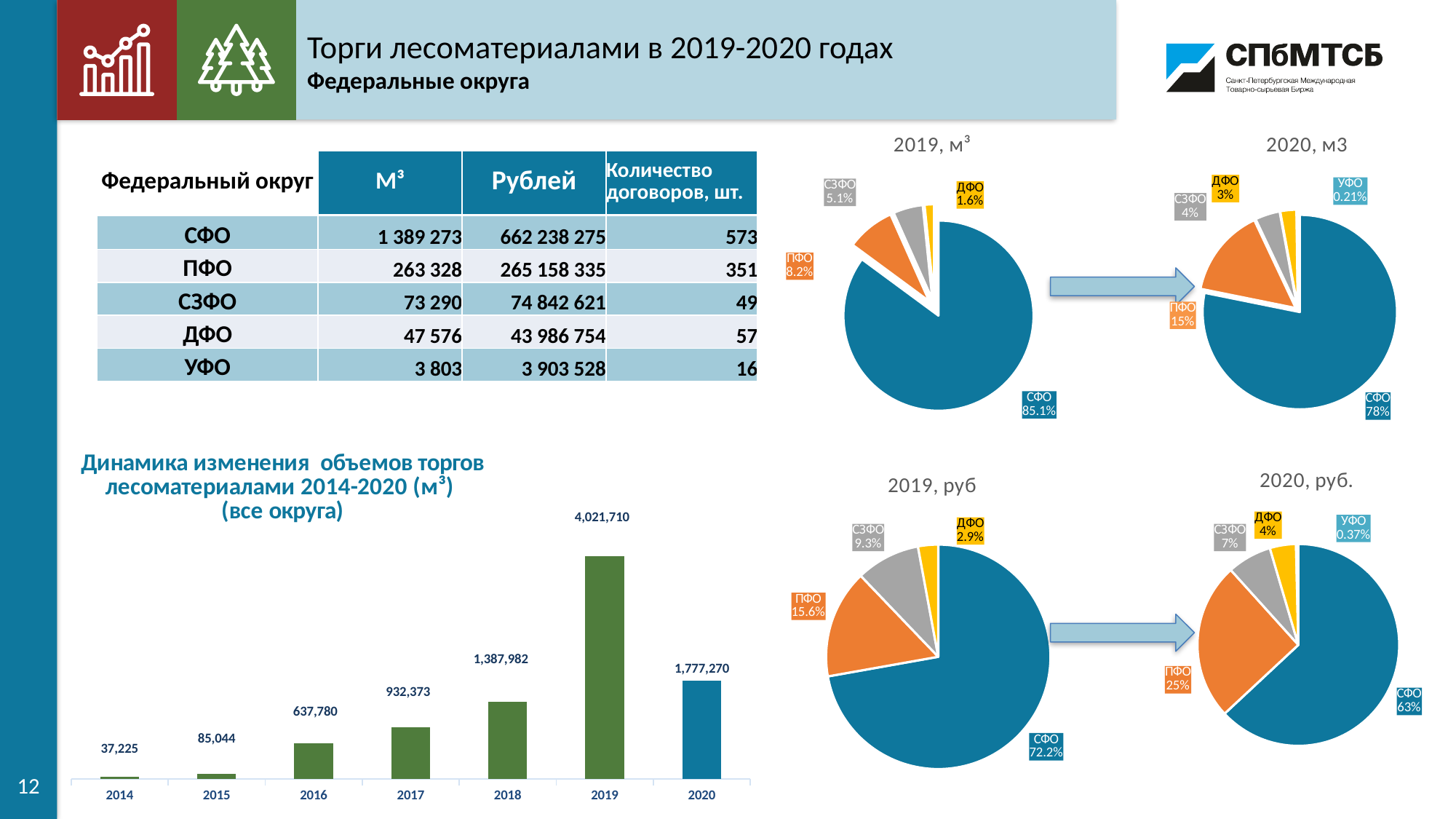
In the bar chart 'Динамика изменения объемов торгов лесоматериалами 2014-2020 (м³)', how many years are shown? 7 In the bar chart 'Динамика изменения объемов торгов лесоматериалами 2014-2020 (м³)', do the values rise or fall from 2014 to 2019? rise In the pie chart '2020, руб.', what share does УФО have? 0.37% In the pie chart '2019, руб', which district has the largest share? СФО In the bar chart 'Динамика изменения объемов торгов лесоматериалами 2014-2020 (м³)', which year has the lowest value? 2014 In the bar chart 'Динамика изменения объемов торгов лесоматериалами 2014-2020 (м³)', what is the value for 2019? 4,021,710 In the pie chart '2019, м³', what share does СФО have? 85.1% In the bar chart 'Динамика изменения объемов торгов лесоматериалами 2014-2020 (м³)', which year has the highest value? 2019 In the bar chart 'Динамика изменения объемов торгов лесоматериалами 2014-2020 (м³)', what is the difference between the 2019 and 2020 values? 2,244,440 In the bar chart 'Динамика изменения объемов торгов лесоматериалами 2014-2020 (м³)', what is the value for 2014? 37,225 In the pie chart '2020, м3', what share does ПФО have? 15% What kind of chart is the chart titled 'Динамика изменения объемов торгов лесоматериалами 2014-2020 (м³)'? bar chart